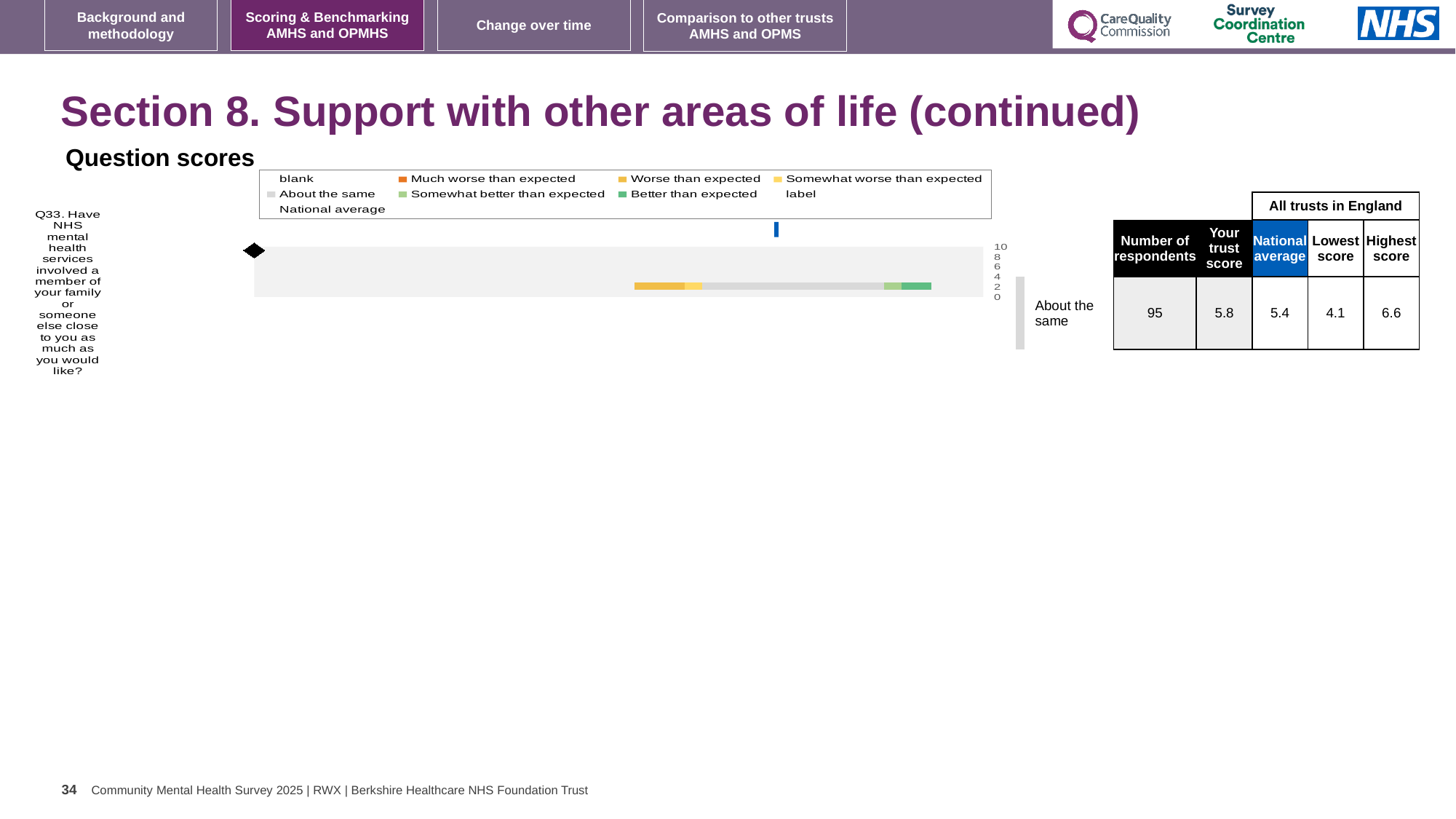
Which benchmark category is the trust's result for Q33 labelled as, next to the chart? About the same In the table beside the chart, what is the difference between the highest and lowest scores for Q33? 2.5 In the table beside the chart, what is the lowest score among all trusts in England for Q33? 4.1 In the table beside the chart, what is the national average for Q33? 5.4 Which question is plotted in the Question scores chart? Q33 What kind of chart is shown under 'Question scores'? bar chart In the table beside the chart, is the trust score for Q33 higher or lower than the national average? higher How many survey questions are plotted in the Question scores chart? 1 In the table beside the chart, what is 'Your trust score' for Q33? 5.8 In the table beside the chart, what is the number of respondents for Q33? 95 Which legend entry in the Question scores chart is shown in orange? Much worse than expected In the table beside the chart, what is the highest score among all trusts in England for Q33? 6.6